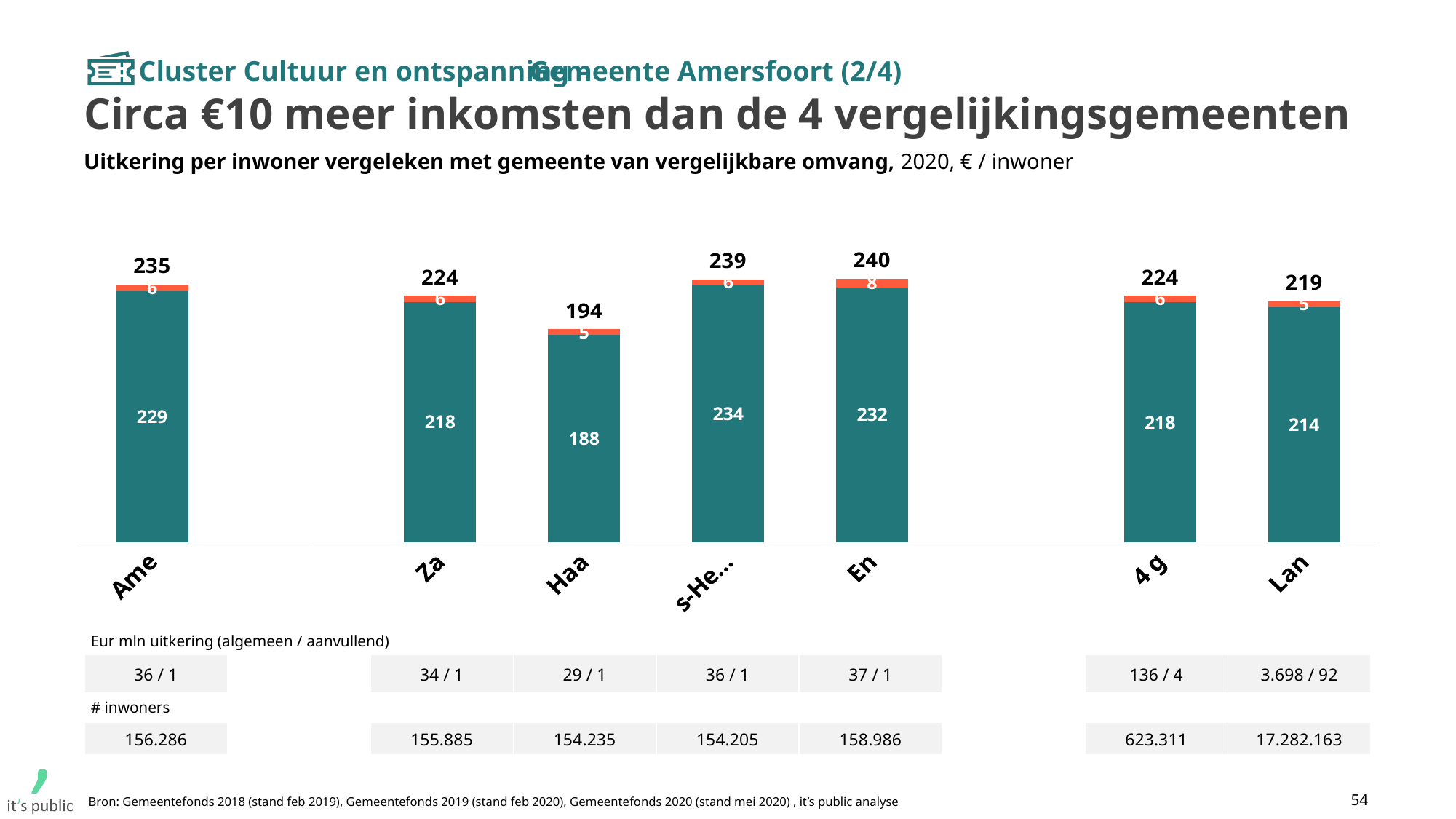
What is the difference between the total for En and the total for Haa? 46 What is the difference between the total for Ame and the total for 4 g? 11 What is the total value shown above the bar for Lan? 219 What is the total of the stacked bar for Za (teal 218 plus orange 6)? 224 What is the value of the teal (lower) segment of the bar for Haa? 188 What kind of chart is shown on the slide? Stacked bar chart What is the total value shown above the bar for Ame? 235 What is the value of the orange (upper) segment of the bar for En? 8 Which category has the lowest total value? Haa Which category has the highest total value? En Which has a larger total value, Za or Lan? Za How many bars (categories) are shown in the chart? 7